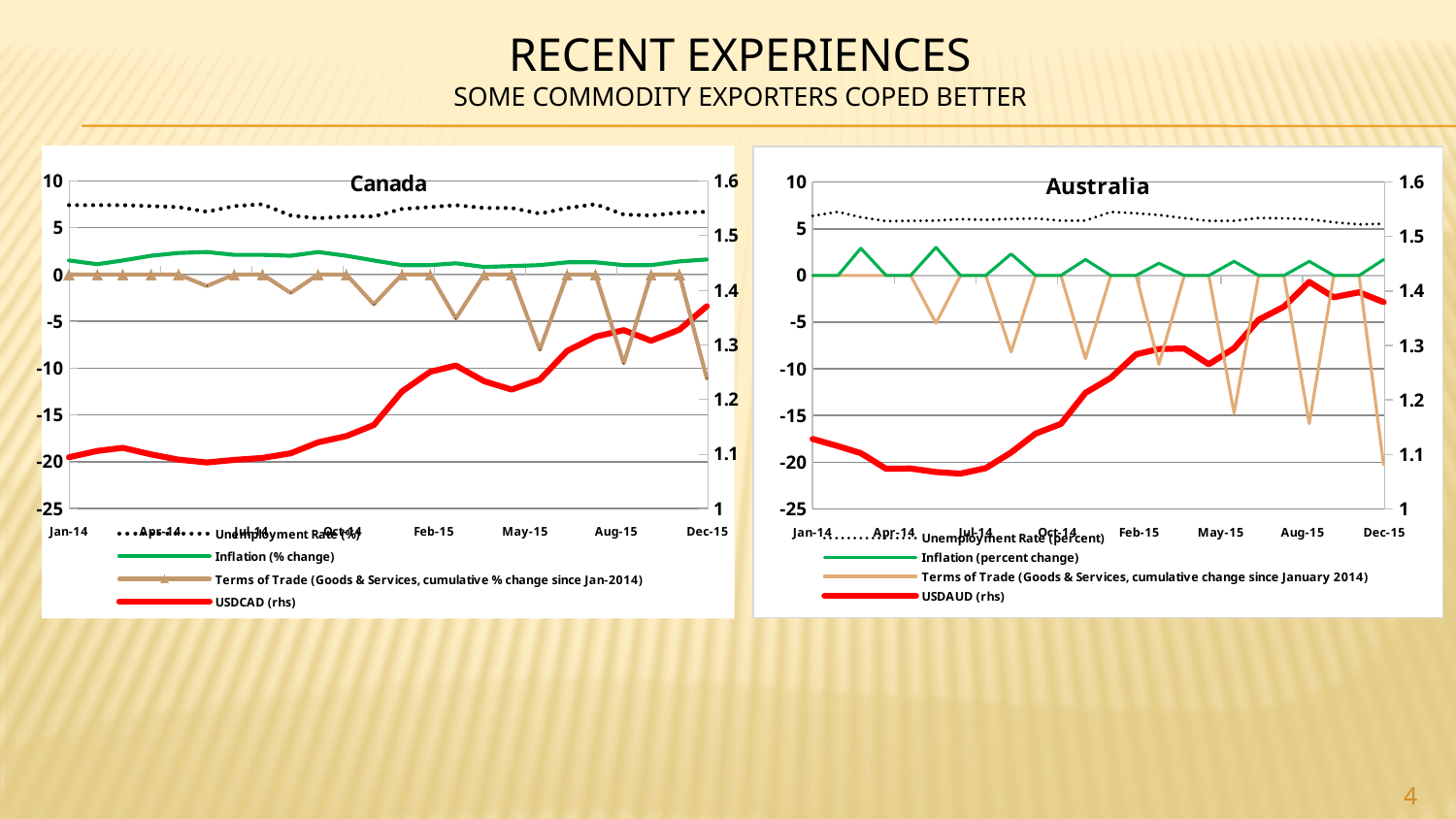
In the Australia chart, does the USDAUD (rhs) line rise or fall from Jan-14 to Dec-15? rise In the Australia chart, is the Terms of Trade value at Dec-15 greater or less than -15? less How many series does the legend of the Canada chart list? 4 In the Canada chart, is the Unemployment Rate (%) at Jan-14 greater or less than 5? greater How many series does the legend of the Australia chart list? 4 In the Canada chart, is the USDCAD (rhs) value larger at Jan-14 or at Dec-15? Dec-15 In the Australia chart, is the USDAUD (rhs) value at Dec-15 greater or less than 1.3 on the right axis? greater What type of chart is the Canada chart? line chart What type of chart is the Australia chart? line chart In the Canada chart, does the USDCAD (rhs) line rise or fall from Jan-14 to Dec-15? rise What is the legend label of the red line in the Australia chart? USDAUD (rhs)